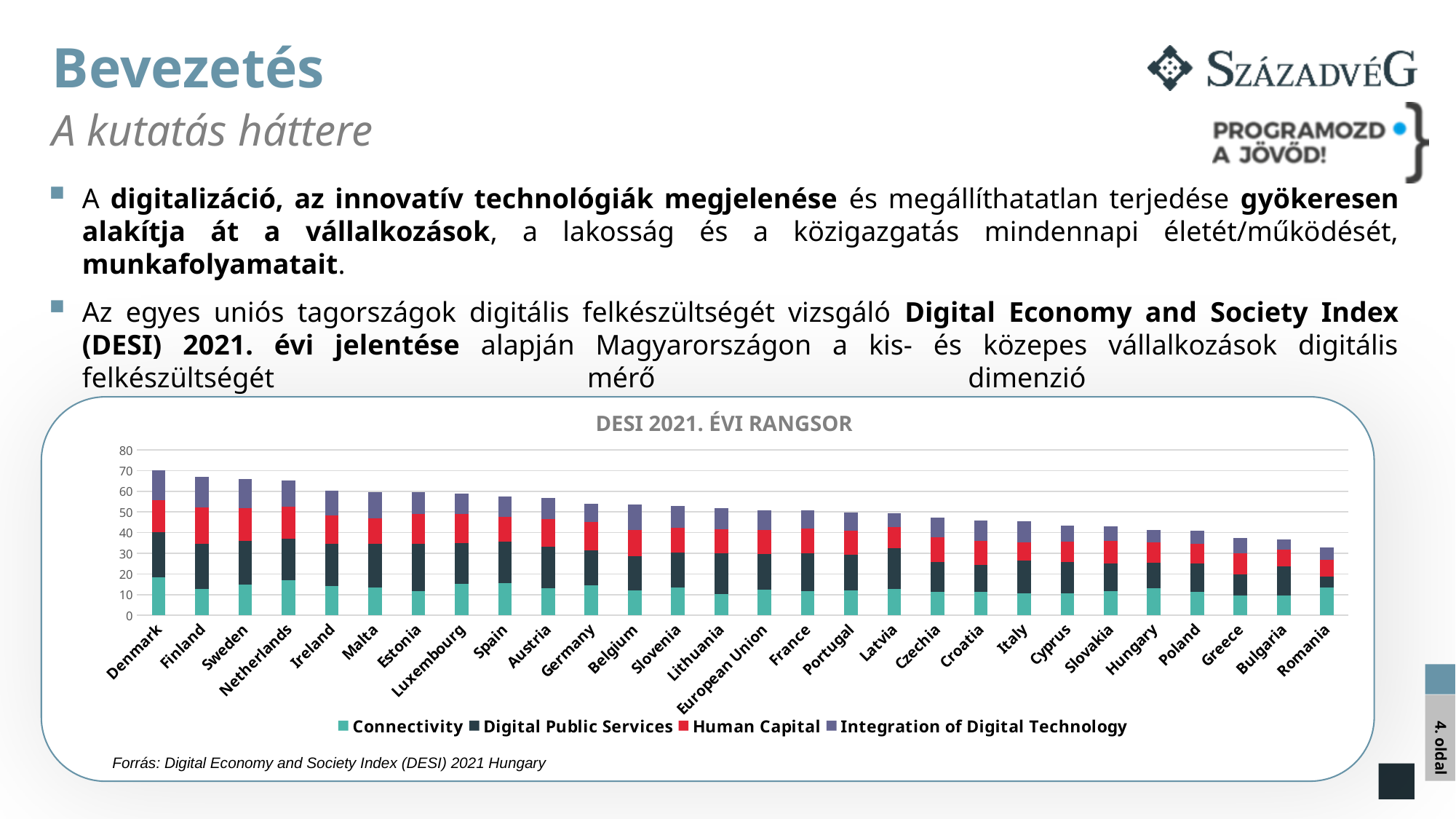
How many countries/categories are shown on the x axis of the chart? 28 How many series does the legend of the DESI 2021. ÉVI RANGSOR chart list? 4 Do the total bar values rise or fall from left to right along the x axis? Fall Which series is shown in red in the chart? Human Capital What kind of chart is shown on the slide? Stacked bar chart Which has a larger total bar, Finland or Greece? Finland What is the title of the chart? DESI 2021. ÉVI RANGSOR Is the total value for Hungary greater or less than 50? less Which category has the lowest total bar in the chart? Romania Is the total value for Romania greater or less than 40? less Is the total value for Denmark greater or less than 60? greater Which category has the highest total bar in the chart? Denmark